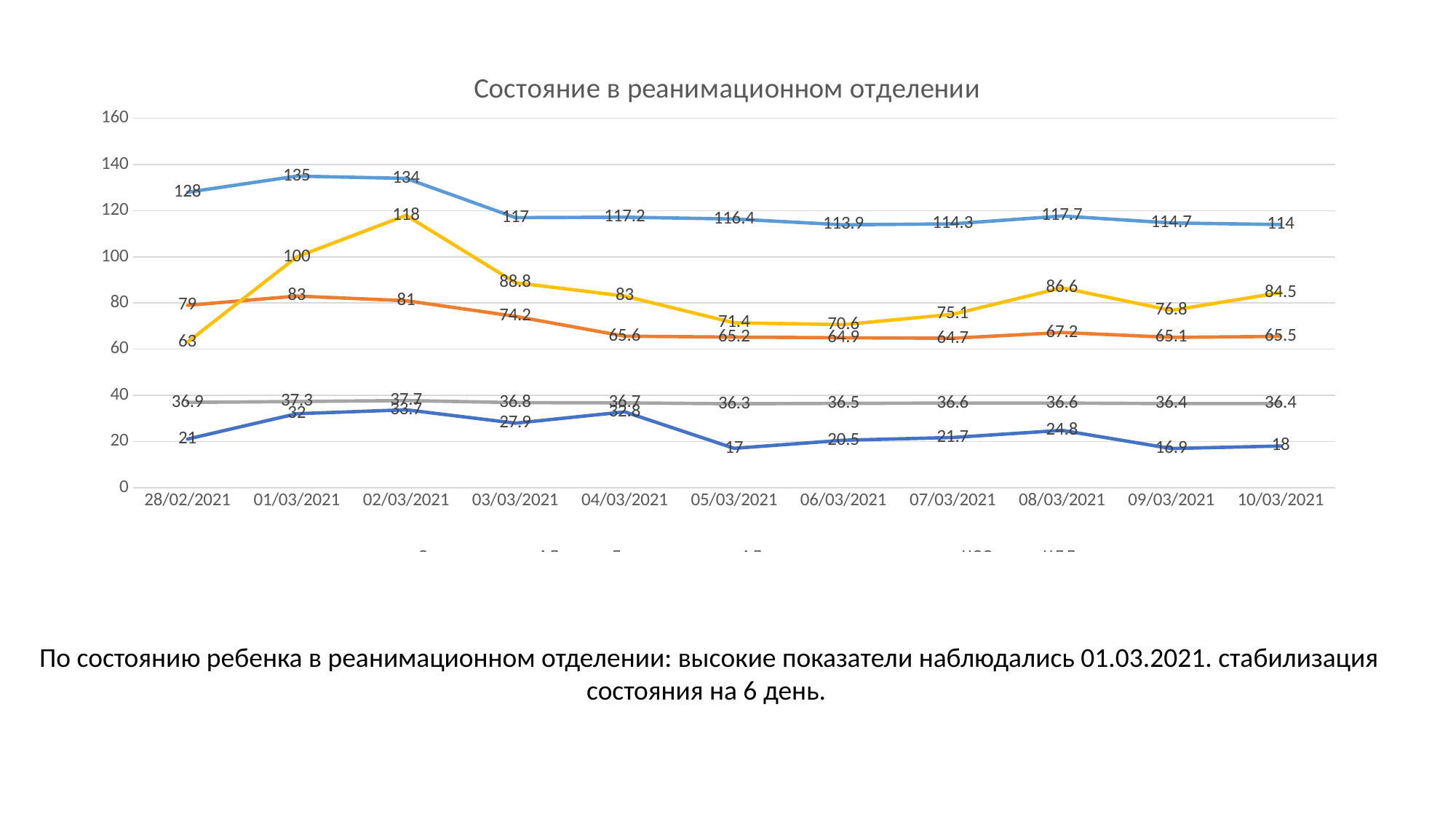
What is the value of the orange line on 10/03/2021? 65.5 How many dates are shown along the x axis of the chart? 11 What is the value of the yellow line on 02/03/2021? 118 How many lines are plotted on the chart? 5 Does the light blue line rise or fall between 02/03/2021 and 03/03/2021? fall On which date does the dark blue line reach its lowest value? 09/03/2021 Which is larger on 28/02/2021: the value of the orange line or the value of the yellow line? orange line What is the difference between the yellow line's values on 02/03/2021 and 03/03/2021? 29.2 What kind of chart is shown on the slide? line chart On which date does the light blue line reach its highest value? 01/03/2021 What is the value of the light blue line on 01/03/2021? 135 What is the title of the chart? Состояние в реанимационном отделении